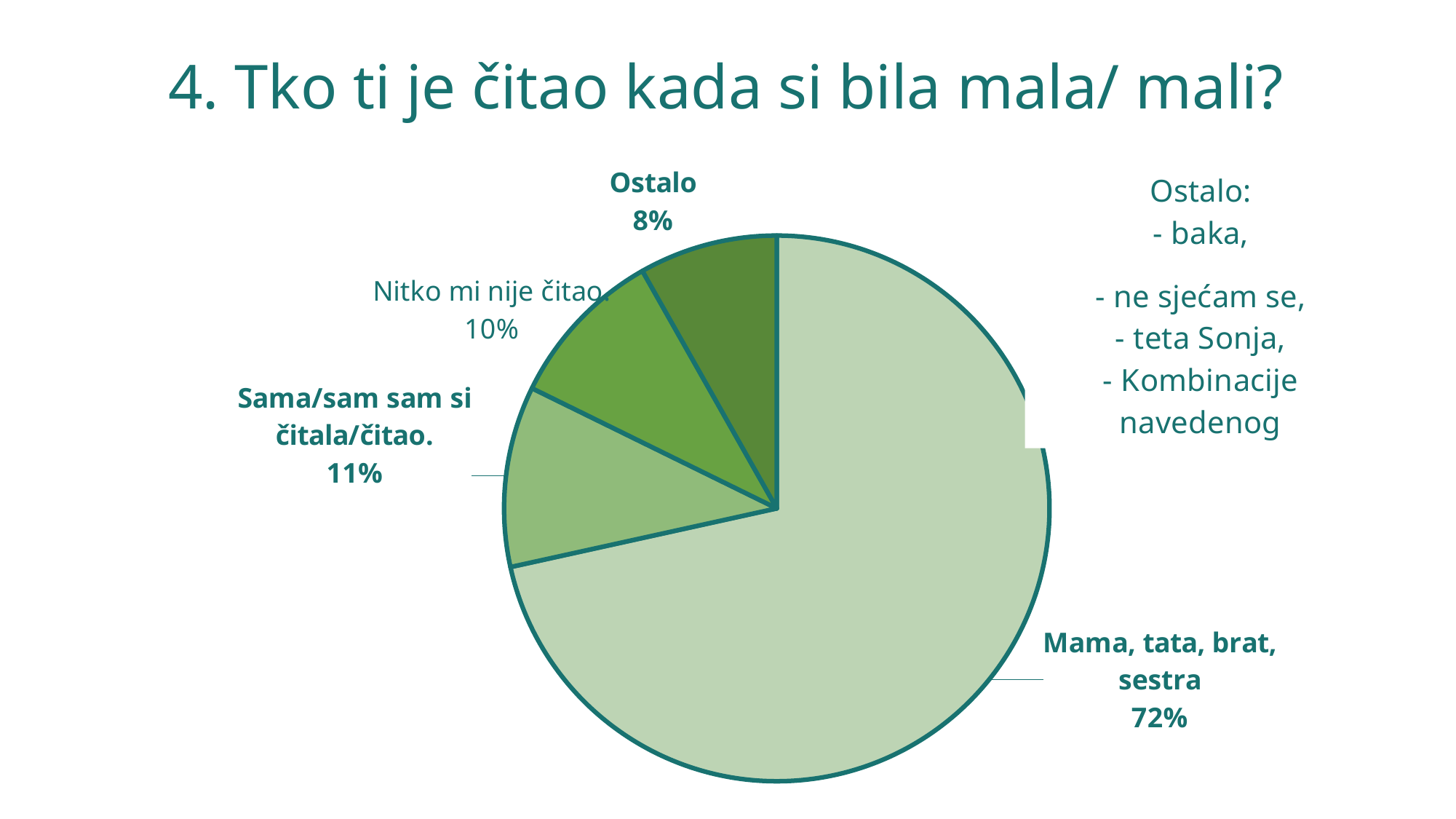
Which category has the smallest slice of the pie? Ostalo What is the difference between the values for "Nitko mi nije čitao." and "Ostalo"? 2% Which is larger, the value for "Sama/sam sam si čitala/čitao." or the value for "Ostalo"? Sama/sam sam si čitala/čitao. What kind of chart is shown on the slide? pie chart What is the value for "Nitko mi nije čitao."? 10% How many slices does the pie chart have? 4 What is the value for "Ostalo"? 8% What is the value for "Sama/sam sam si čitala/čitao."? 11% What is the difference between the values for "Mama, tata, brat, sestra" and "Sama/sam sam si čitala/čitao."? 61% Which category has the largest slice of the pie? Mama, tata, brat, sestra What share of the pie does "Mama, tata, brat, sestra" have? 72% What is the title of the slide containing the pie chart? 4. Tko ti je čitao kada si bila mala/ mali?